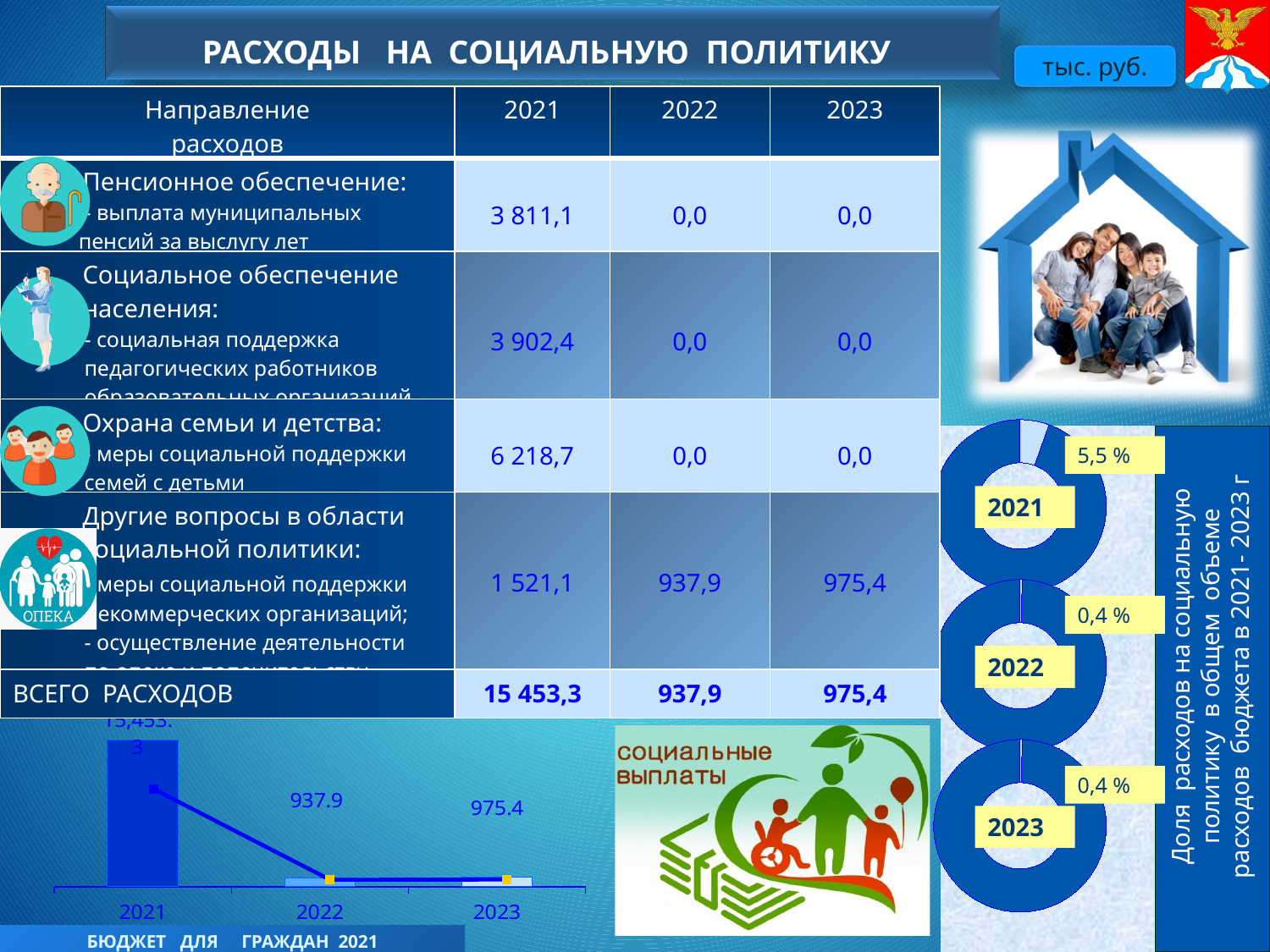
On the bar chart at the bottom left, do the values rise or fall from 2021 to 2022? Fall On the donut charts on the right, what share is shown for 2021? 5,5 % On the bar chart at the bottom left, which year has the highest value? 2021 On the bar chart at the bottom left, which is larger: the value for 2022 or the value for 2023? 2023 On the donut charts on the right, what share is shown for 2023? 0,4 % On the bar chart at the bottom left, what is the value for 2023? 975.4 How many years are shown on the bar chart at the bottom left? 3 On the bar chart at the bottom left, what is the value for 2022? 937.9 On the bar chart at the bottom left, which year has the lowest value? 2022 On the bar chart at the bottom left, what is the difference between the values for 2023 and 2022? 37.5 Among the three donut charts on the right, which year shows the highest share? 2021 What kind of chart is shown at the bottom left of the slide? Bar chart (with a line overlay)